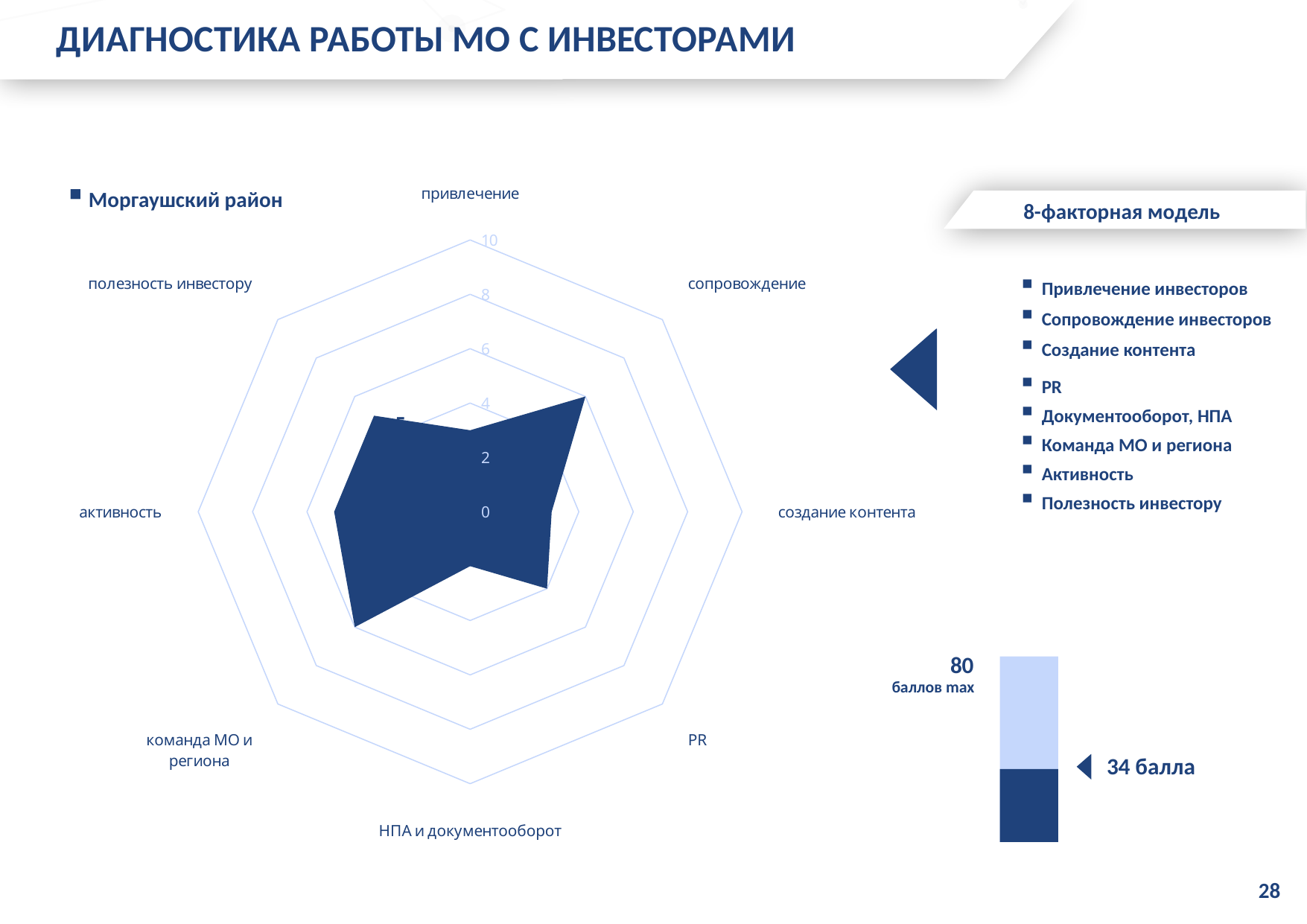
What is the name of the series shown in the radar chart's legend? Моргаушский район What kind of chart is the main chart on the slide? radar chart In the radar chart, is the value for команда МО и региона greater or less than 4? greater In the radar chart, is the value for активность greater or less than 4? greater What is the maximum value shown on the radar chart's scale? 10 How many categories (axes) does the radar chart have? 8 How many series does the radar chart's legend list? 1 In the radar chart, which is larger: the value for сопровождение or the value for привлечение? сопровождение In the radar chart, is the value for сопровождение greater or less than 4? greater In the bar on the right of the slide, what score is marked for the district out of the 80-point maximum? 34 балла